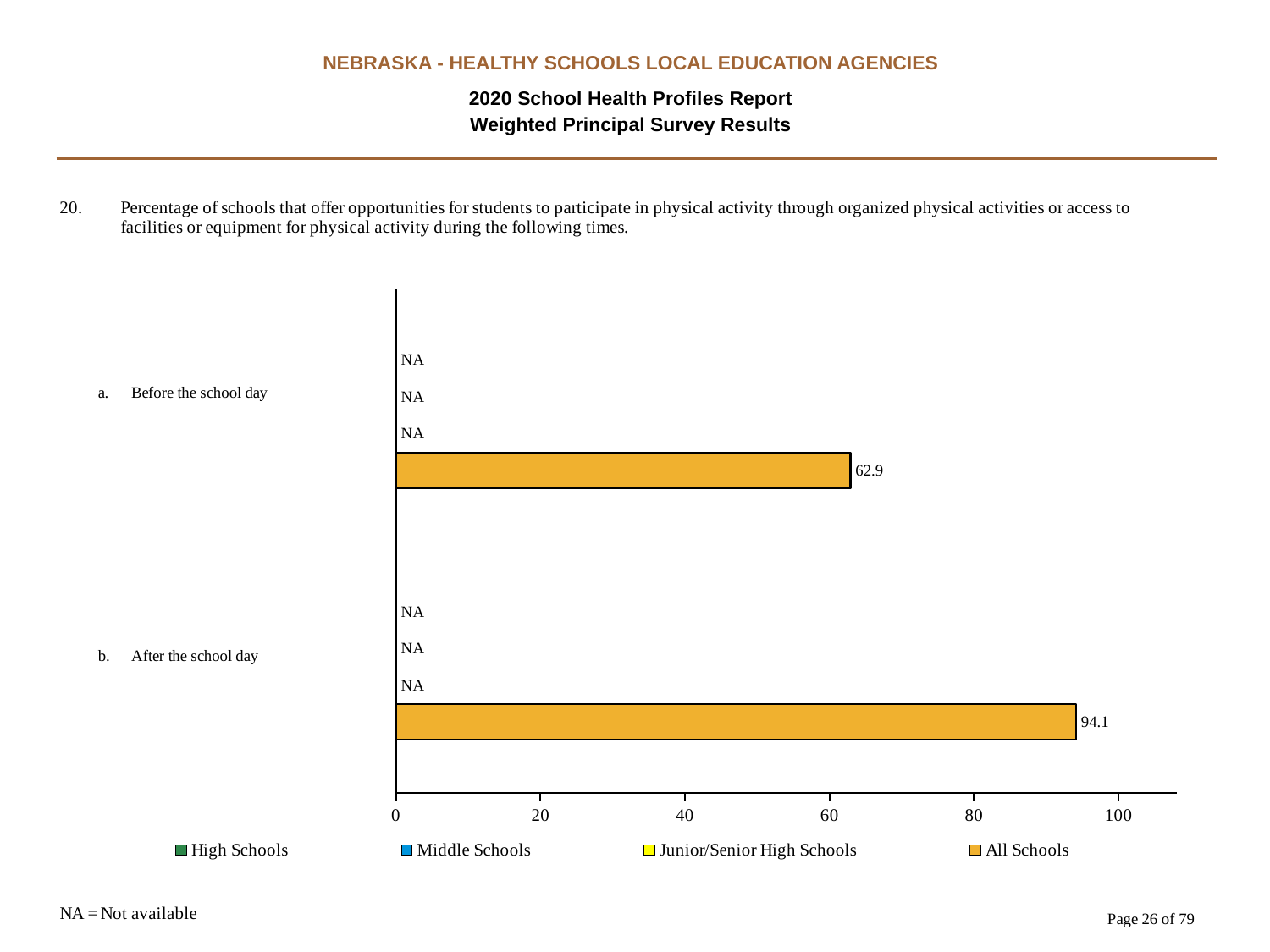
What value is shown for High Schools for 'Before the school day'? NA What is the value for All Schools for 'Before the school day'? 62.9 How many categories are shown on the chart? 2 Which series is shown in the legend with an orange/gold colour? All Schools What is the difference between the All Schools values for 'After the school day' and 'Before the school day'? 31.2 What kind of chart is shown on the slide? Bar chart Which category has the higher All Schools value, 'Before the school day' or 'After the school day'? After the school day What value is shown for Middle Schools for 'After the school day'? NA Is the All Schools value for 'Before the school day' greater or less than 60? greater Is the All Schools value for 'After the school day' greater or less than 80? greater What is the value for All Schools for 'After the school day'? 94.1 How many series does the legend list? 4